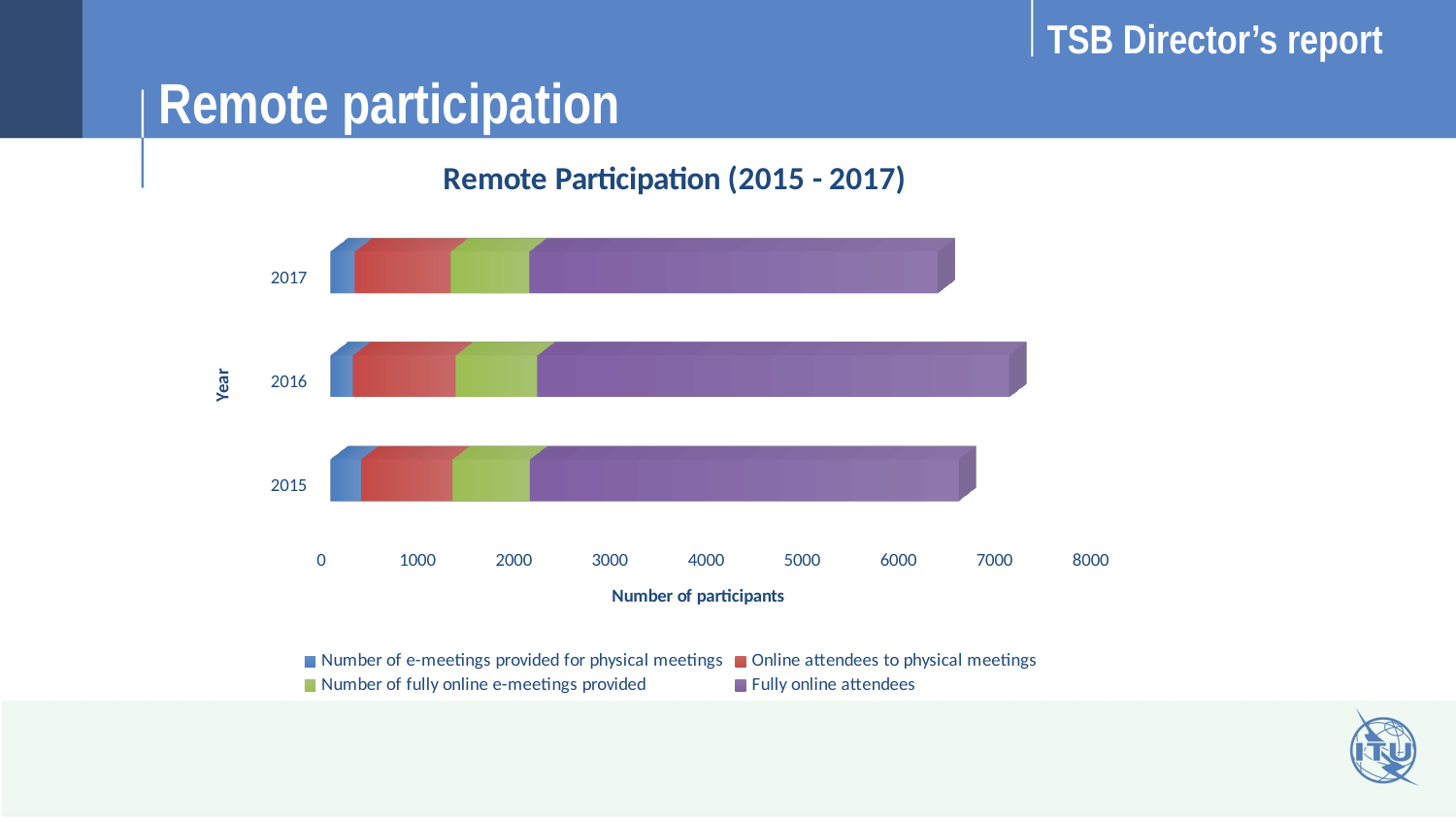
What is the label of the horizontal axis? Number of participants Which series forms the largest segment of the 2016 bar? Fully online attendees Which year has a larger total bar, 2016 or 2017? 2016 Which series forms the smallest segment of the 2015 bar? Number of e-meetings provided for physical meetings Which year has the longest total bar? 2016 Is the total bar for 2015 greater or less than 6000? greater Is the total bar for 2017 greater or less than 7000? less How many series does the legend list? 4 What is the title of the chart? Remote Participation (2015 - 2017) Is the total bar for 2016 greater or less than 6000? greater How many years are plotted on the chart? 3 What kind of chart is shown on the slide? bar chart